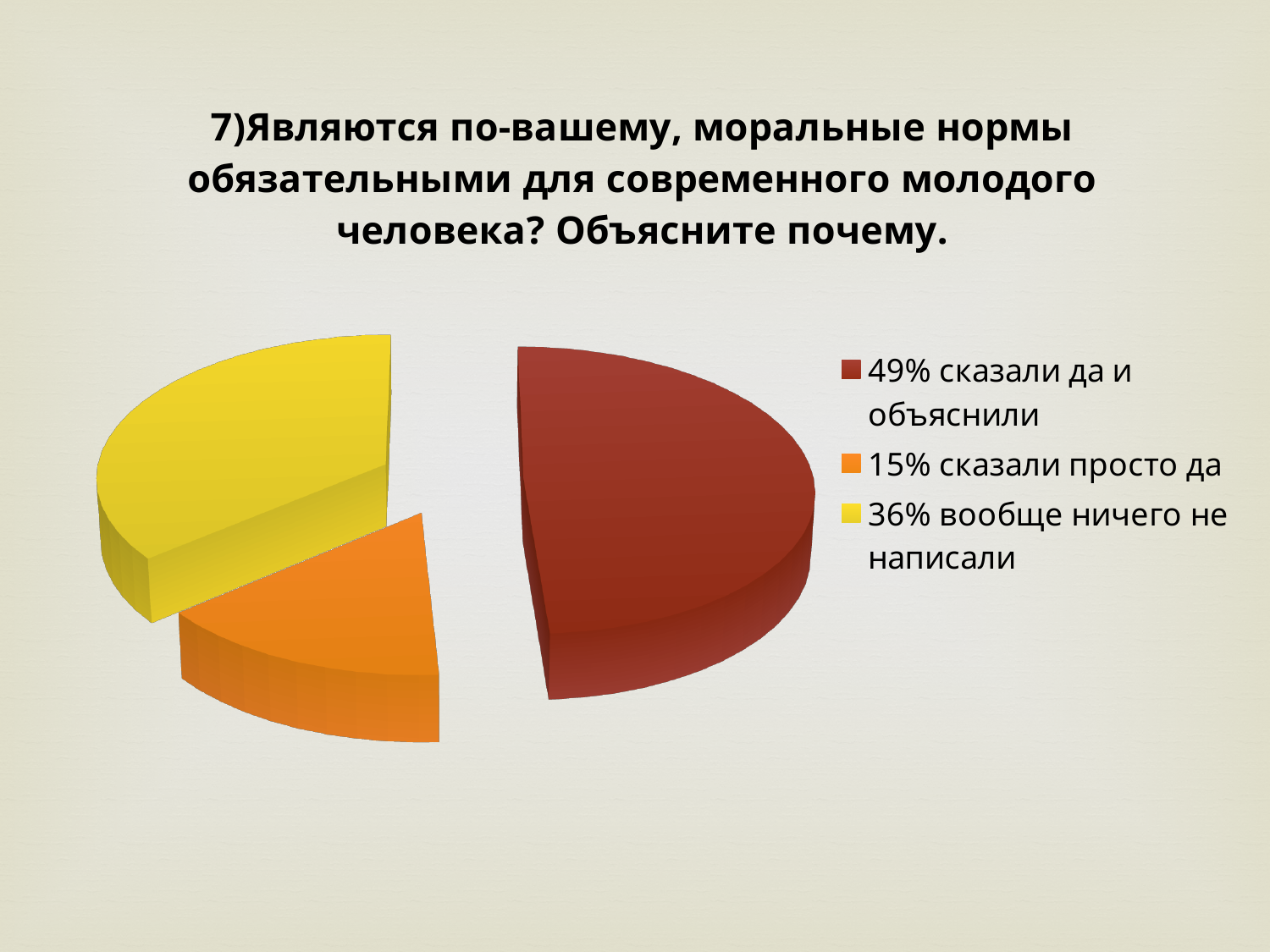
Which category has the largest slice of the pie? 49% сказали да и объяснили What is the difference in percentage points between those who said yes and explained and those who wrote nothing? 13 What colour is the slice for "36% вообще ничего не написали"? yellow Which is larger: the share who wrote nothing or the share who simply said yes? the share who wrote nothing (36%) What kind of chart is shown on the slide? pie chart Which category has the smallest slice of the pie? 15% сказали просто да What colour is the slice for "49% сказали да и объяснили"? dark red What share of respondents said yes and explained ("сказали да и объяснили")? 49% How many entries does the legend list? 3 What share of respondents wrote nothing at all ("вообще ничего не написали")? 36% How many slices does the pie chart have? 3 What share of respondents simply said yes ("сказали просто да")? 15%